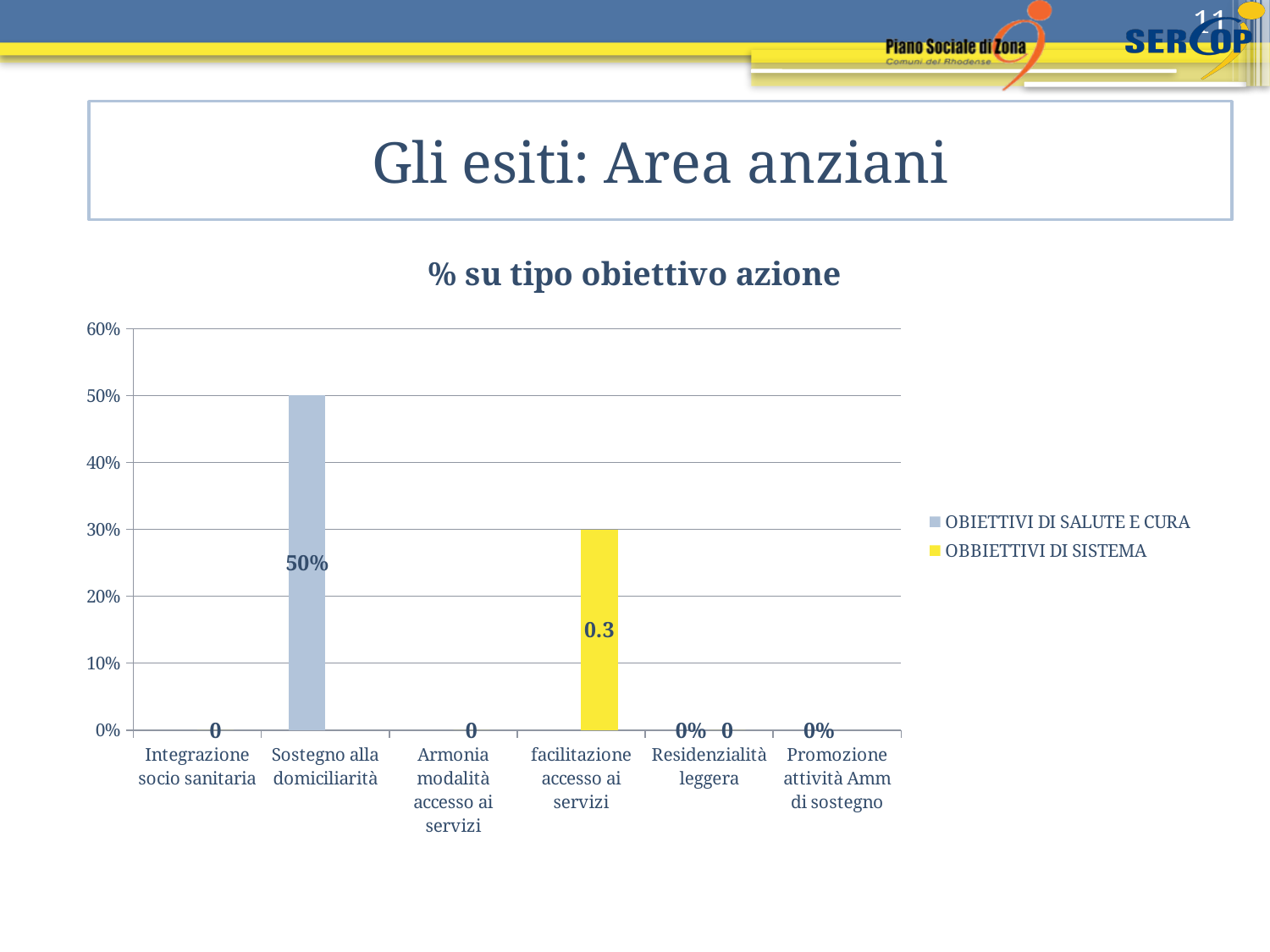
What is the title of the chart? % su tipo obiettivo azione How many series does the legend list? 2 Is the value for facilitazione accesso ai servizi greater or less than 40%? less Is the value for Sostegno alla domiciliarità greater or less than 40%? greater Which is larger, the bar for Sostegno alla domiciliarità or the bar for facilitazione accesso ai servizi? Sostegno alla domiciliarità What kind of chart is shown on the slide? bar chart Which category has the highest bar in the chart? Sostegno alla domiciliarità Which series does the yellow bar belong to, according to the legend? OBBIETTIVI DI SISTEMA What is the data label on the bar for Sostegno alla domiciliarità? 50% How many categories are shown on the x axis of the chart? 6 What is the data label shown for Promozione attività Amm di sostegno? 0% What is the data label on the bar for facilitazione accesso ai servizi? 0.3